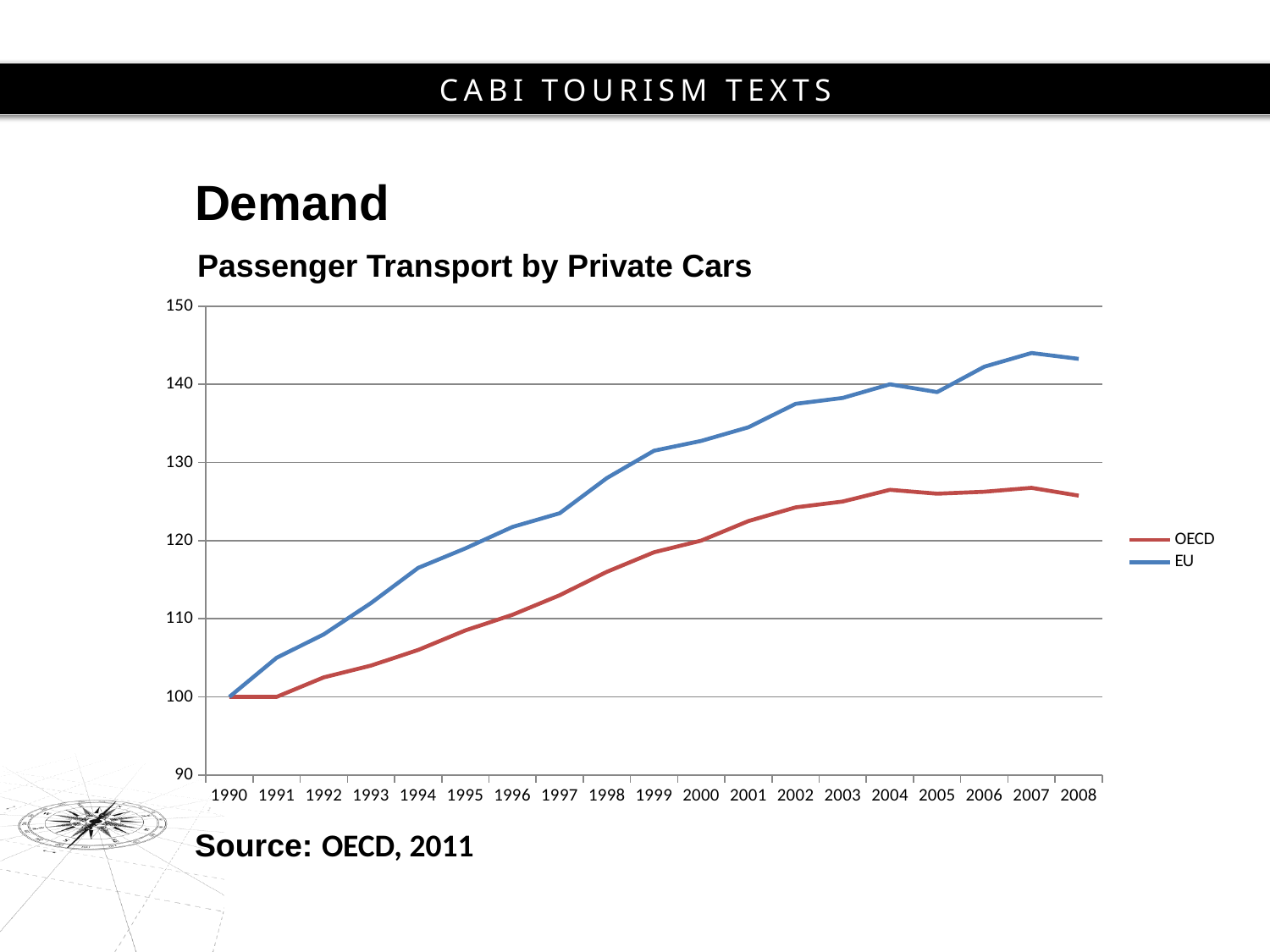
Do the values for EU generally rise or fall from 1990 to 2008? rise What is the value for OECD in 1990? 100 What kind of chart is shown on the slide? line chart What is the value for EU in 1990? 100 Is the value for EU in 2000 greater or less than 130? greater How many years are shown on the x axis? 19 Which series has the higher value in 2008, OECD or EU? EU Is the value for OECD in 1995 greater or less than 110? less How many series does the legend list? 2 In which year does the EU series reach its highest value? 2007 Is the value for EU in 2008 greater or less than 140? greater